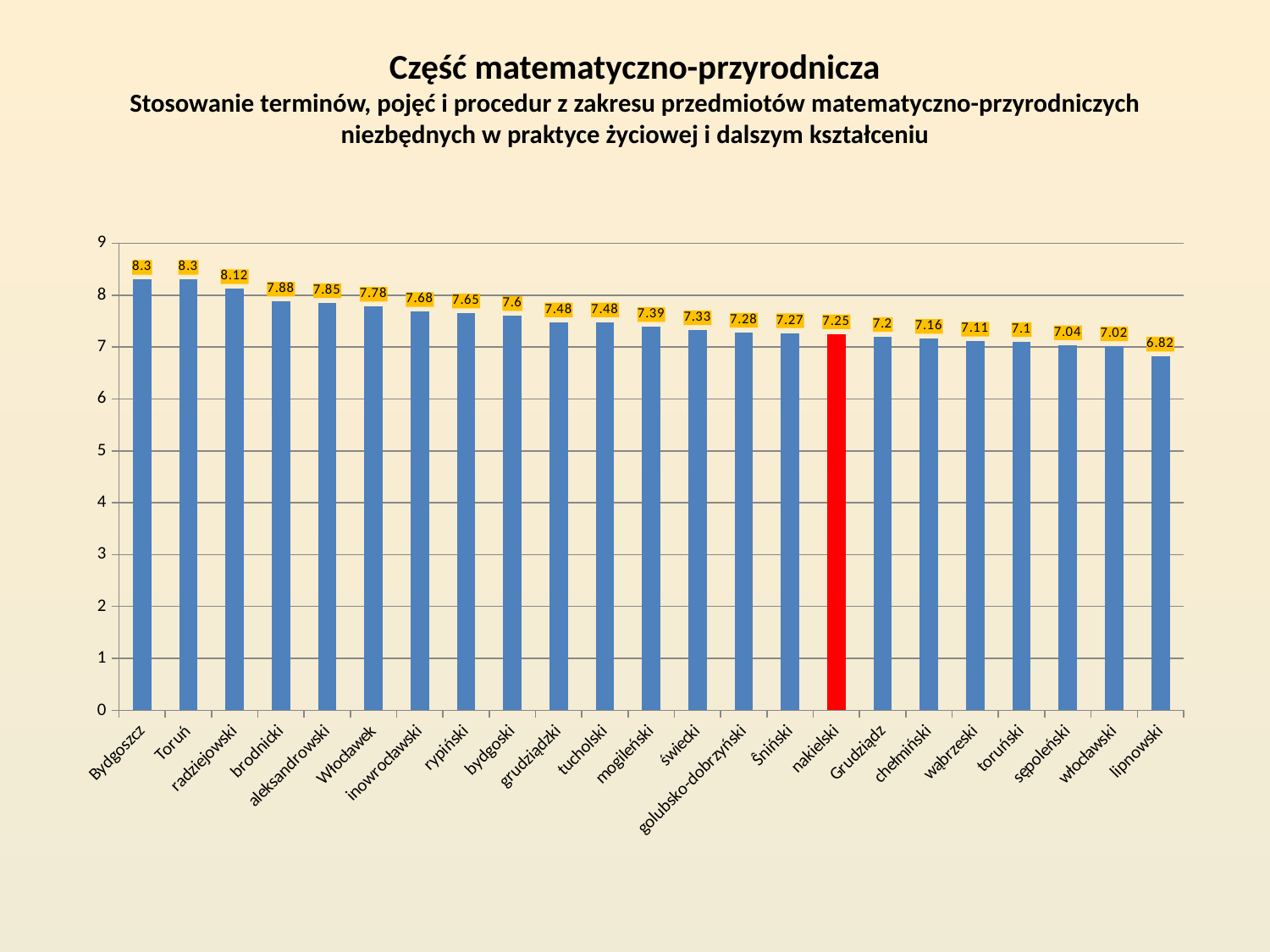
What is the difference between the values for Toruń and toruński? 1.2 What is the value for świecki? 7.33 What kind of chart is shown on the slide? bar chart Is the value for lipnowski greater or less than 7? less What is the value for radziejowski? 8.12 Which category has the lowest value? lipnowski Which category's bar is coloured red? nakielski Which has a larger value, Włocławek or Grudziądz? Włocławek Do the values rise or fall from left to right along the x axis? fall What is the difference between the values for Bydgoszcz and lipnowski? 1.48 How many categories are shown on the x axis? 23 What is the value for nakielski? 7.25